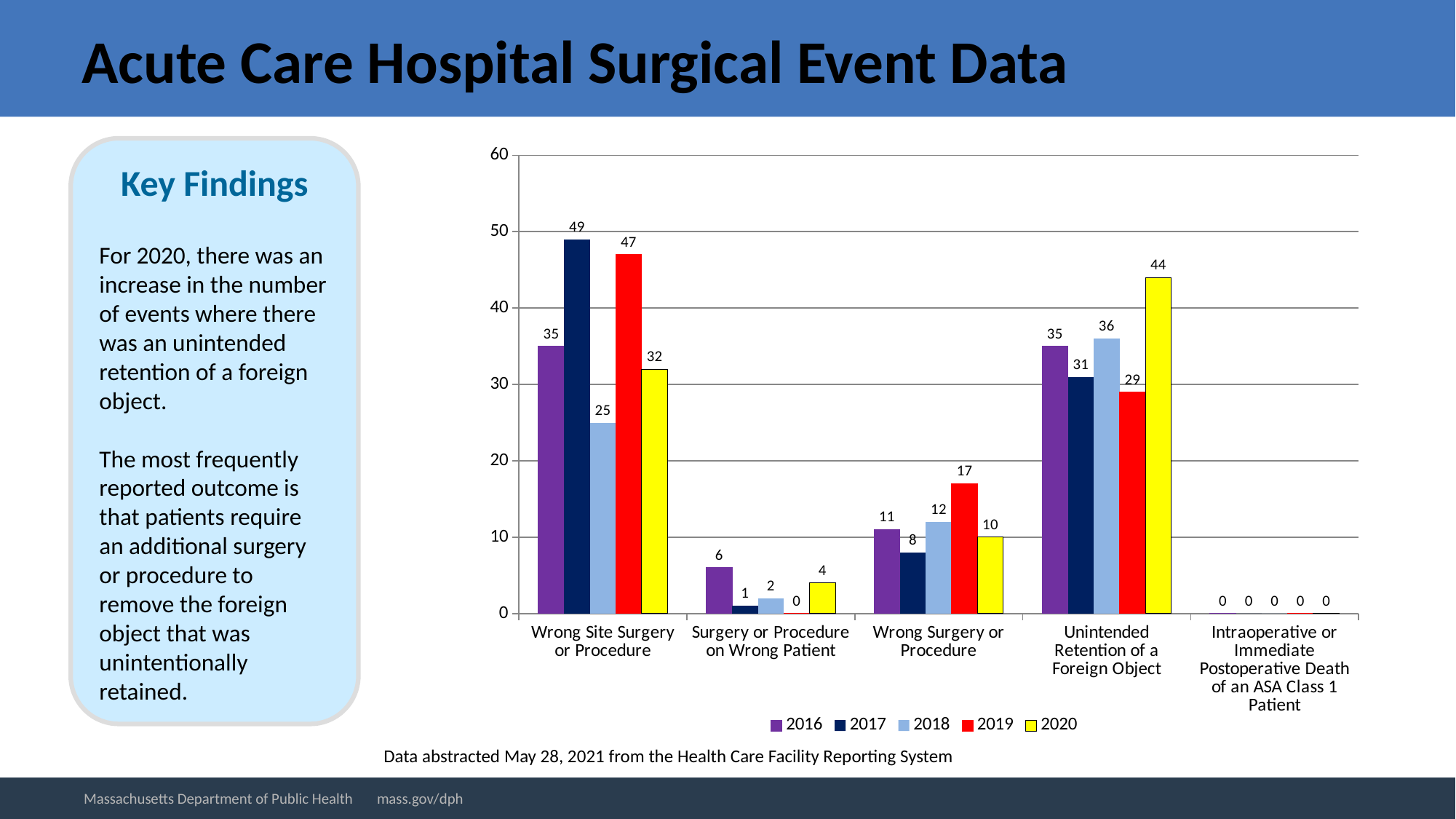
Which colour represents 2020 in the legend? Yellow How many series does the legend list? 5 What kind of chart is shown on the slide? Bar chart Which is larger for Wrong Site Surgery or Procedure: the 2016 value or the 2020 value? 2016 Which year has the lowest value for Wrong Site Surgery or Procedure? 2018 What is the value for Surgery or Procedure on Wrong Patient in 2019? 0 How many event categories are shown on the x axis? 5 What is the value for Wrong Site Surgery or Procedure in 2017? 49 What is the difference between the 2020 and 2019 values for Unintended Retention of a Foreign Object? 15 Which year has the highest value for Wrong Surgery or Procedure? 2019 Is the 2018 value for Unintended Retention of a Foreign Object greater or less than 30? greater What is the value for Unintended Retention of a Foreign Object in 2020? 44